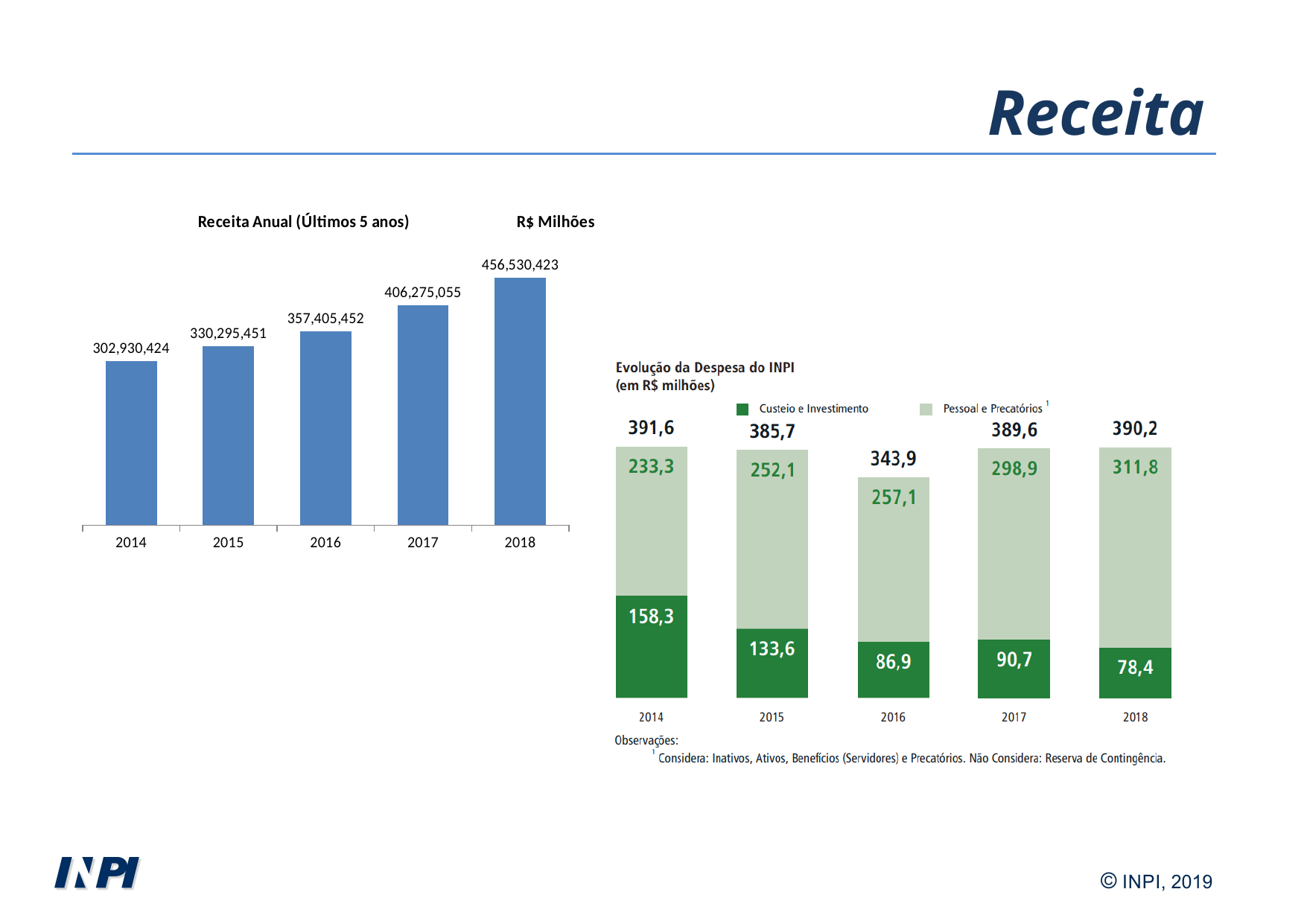
In the 'Evolução da Despesa do INPI' chart, what is the difference between the 'Pessoal e Precatórios' values for 2018 and 2014? 78,5 In the 'Evolução da Despesa do INPI' chart, which is larger for 2016: 'Custeio e Investimento' or 'Pessoal e Precatórios'? Pessoal e Precatórios In the 'Evolução da Despesa do INPI' chart, what is the total of the stacked bar for 2016? 343,9 In the 'Receita Anual (Últimos 5 anos)' chart, which year has the lowest value? 2014 In the 'Evolução da Despesa do INPI' chart, what is the value of 'Custeio e Investimento' for 2015? 133,6 In the 'Evolução da Despesa do INPI' chart, how many series does the legend list? 2 In the 'Evolução da Despesa do INPI' chart, what is the value of 'Pessoal e Precatórios' for 2017? 298,9 In the 'Evolução da Despesa do INPI' chart, which year has the highest 'Custeio e Investimento' value? 2014 In the 'Receita Anual (Últimos 5 anos)' chart, what is the value for 2018? 456,530,423 What kind of chart is the 'Receita Anual (Últimos 5 anos)' chart? bar chart In the 'Receita Anual (Últimos 5 anos)' chart, how many years are shown? 5 In the 'Receita Anual (Últimos 5 anos)' chart, do the values rise or fall from 2014 to 2018? rise